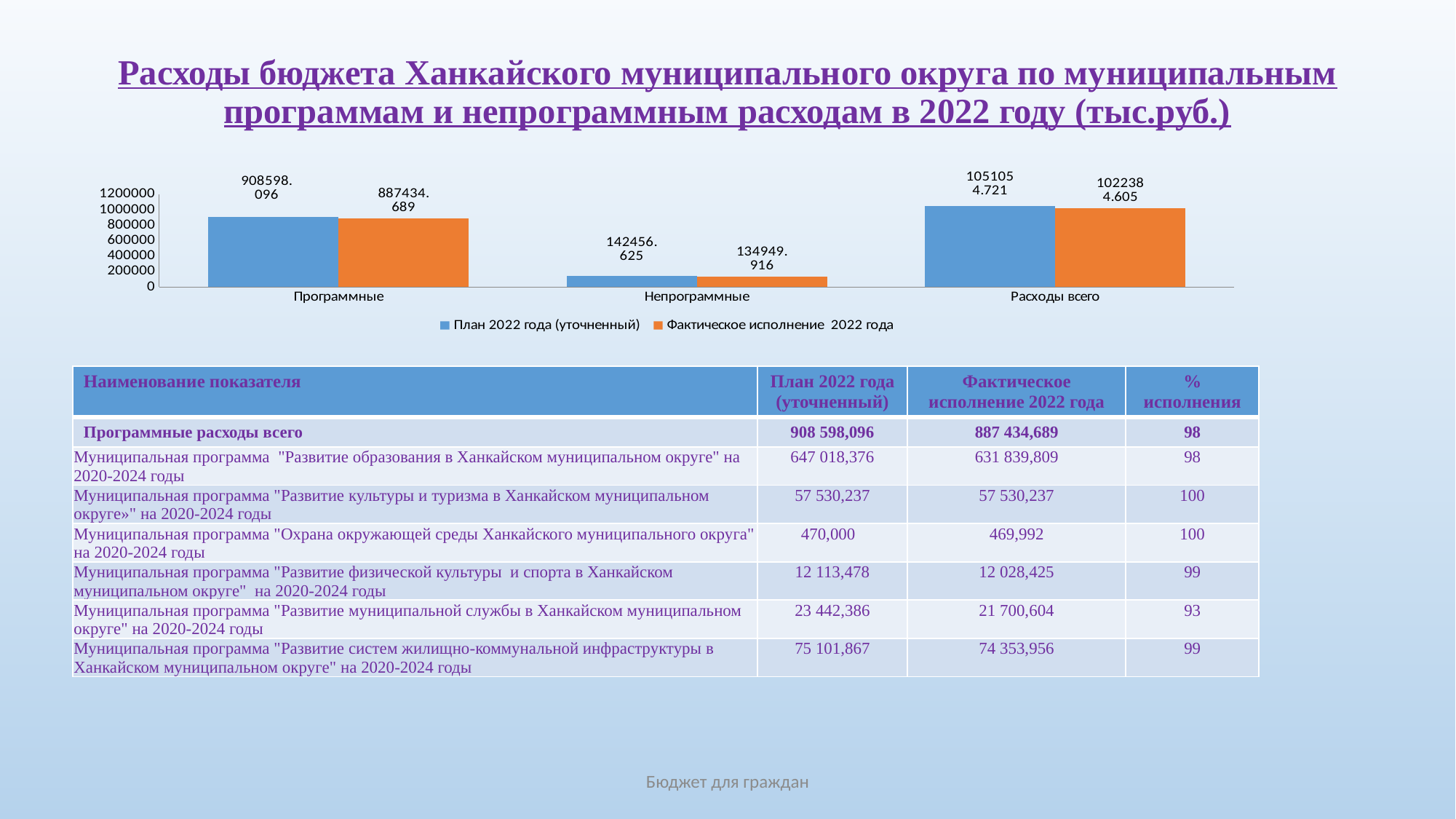
Which is larger for Непрограммные: План 2022 года (уточненный) or Фактическое исполнение 2022 года? План 2022 года (уточненный) What is the difference between План 2022 года (уточненный) and Фактическое исполнение 2022 года for Программные? 21163.407 What is the value of Фактическое исполнение 2022 года for Расходы всего? 1022384.605 How many series does the chart legend list? 2 Which colour represents Фактическое исполнение 2022 года in the chart? orange What type of chart is shown on the slide? bar chart What is the value of Фактическое исполнение 2022 года for Непрограммные? 134949.916 Which category has the lowest value for План 2022 года (уточненный)? Непрограммные Which category has the highest value for Фактическое исполнение 2022 года? Расходы всего How many categories are shown on the x axis of the chart? 3 What is the value of План 2022 года (уточненный) for Программные? 908598.096 What is the value of План 2022 года (уточненный) for Расходы всего? 1051054.721